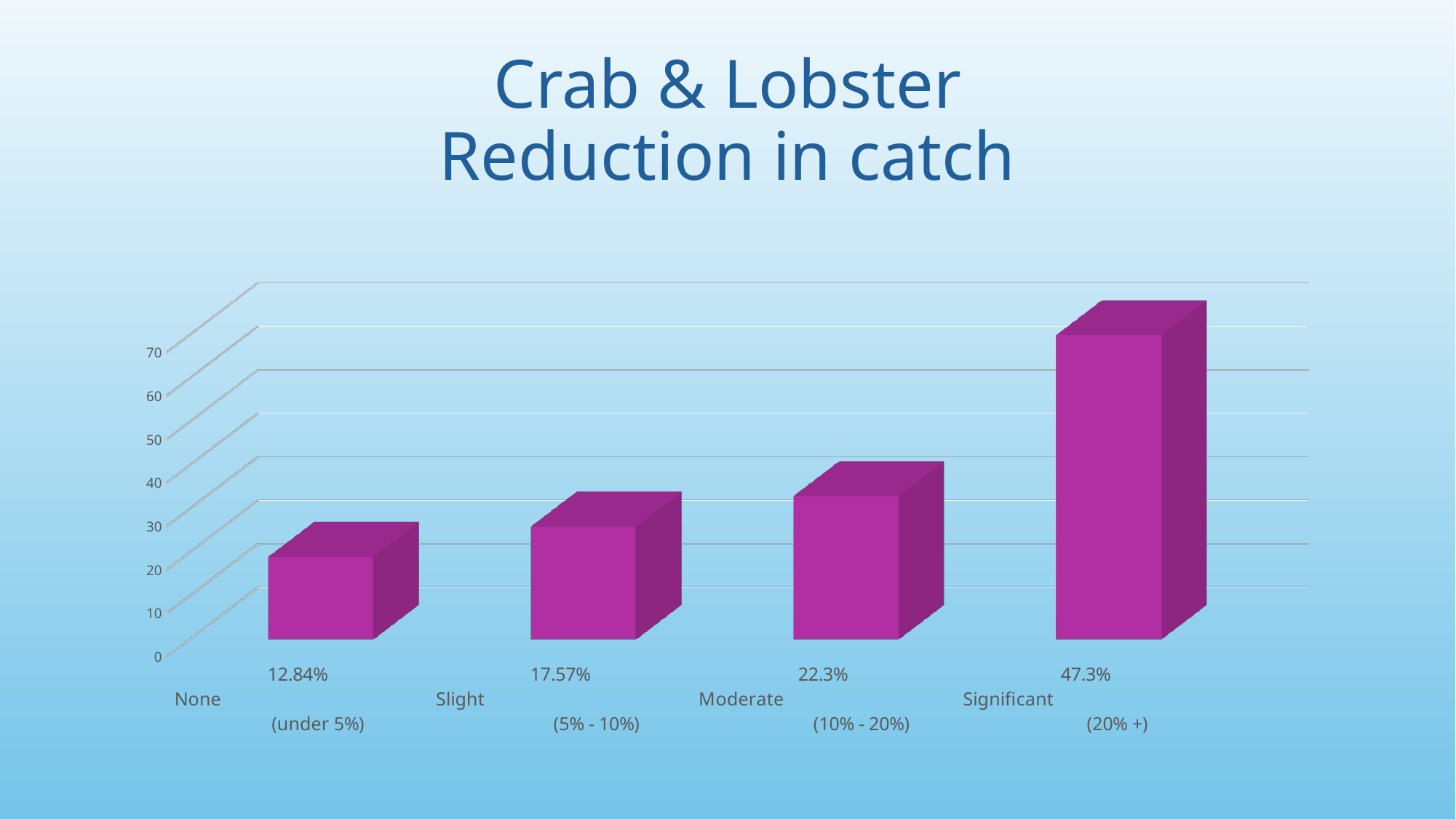
Which category has the highest value? Significant (20% +) Which category has the lowest value? None (under 5%) How many categories are shown in the chart? 4 Which is larger, the value for Moderate or the value for Slight? Moderate Do the values rise or fall from None to Significant along the x axis? Rise What kind of chart is shown on the slide? Bar chart